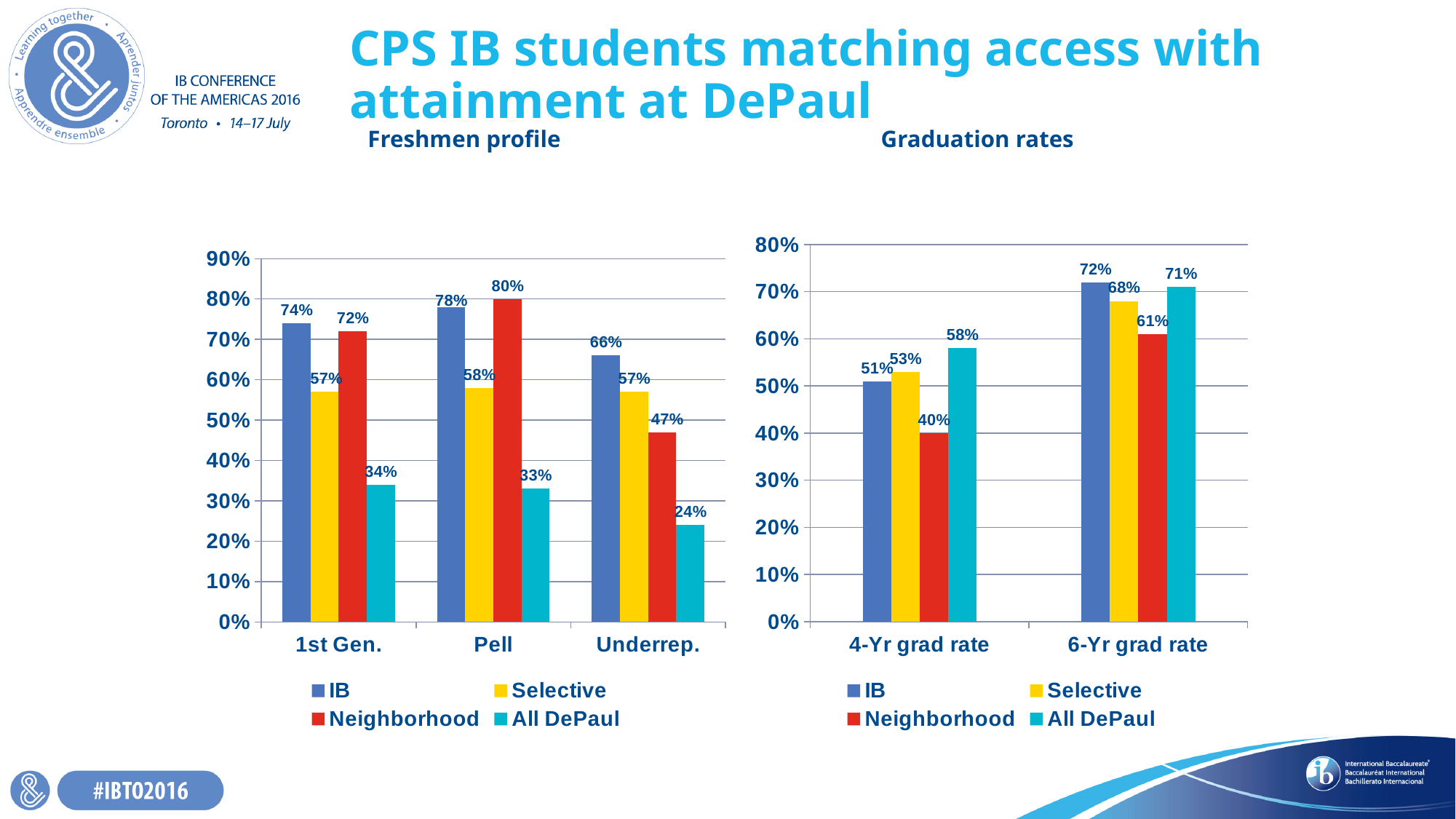
In the Graduation rates chart, which series has the highest 4-Yr grad rate? All DePaul In the Graduation rates chart, is the 6-Yr grad rate for Selective larger or smaller than the 6-Yr grad rate for Neighborhood? larger In the Graduation rates chart, how many series does the legend list? 4 In the Freshmen profile chart, which series has the highest value in the Pell category? Neighborhood In the Freshmen profile chart, which series has the lowest value in the 1st Gen. category? All DePaul In the Freshmen profile chart, what is the value for All DePaul in the Underrep. category? 24% In the Freshmen profile chart, what is the value for IB in the 1st Gen. category? 74% In the Graduation rates chart, what is the 6-Yr grad rate for IB? 72% In the Freshmen profile chart, what is the difference between the IB and Selective values in the Underrep. category? 9% In the Graduation rates chart, what is the 4-Yr grad rate for Neighborhood? 40% What kind of chart is the Graduation rates chart? bar chart In the Freshmen profile chart, how many categories are shown on the x axis? 3